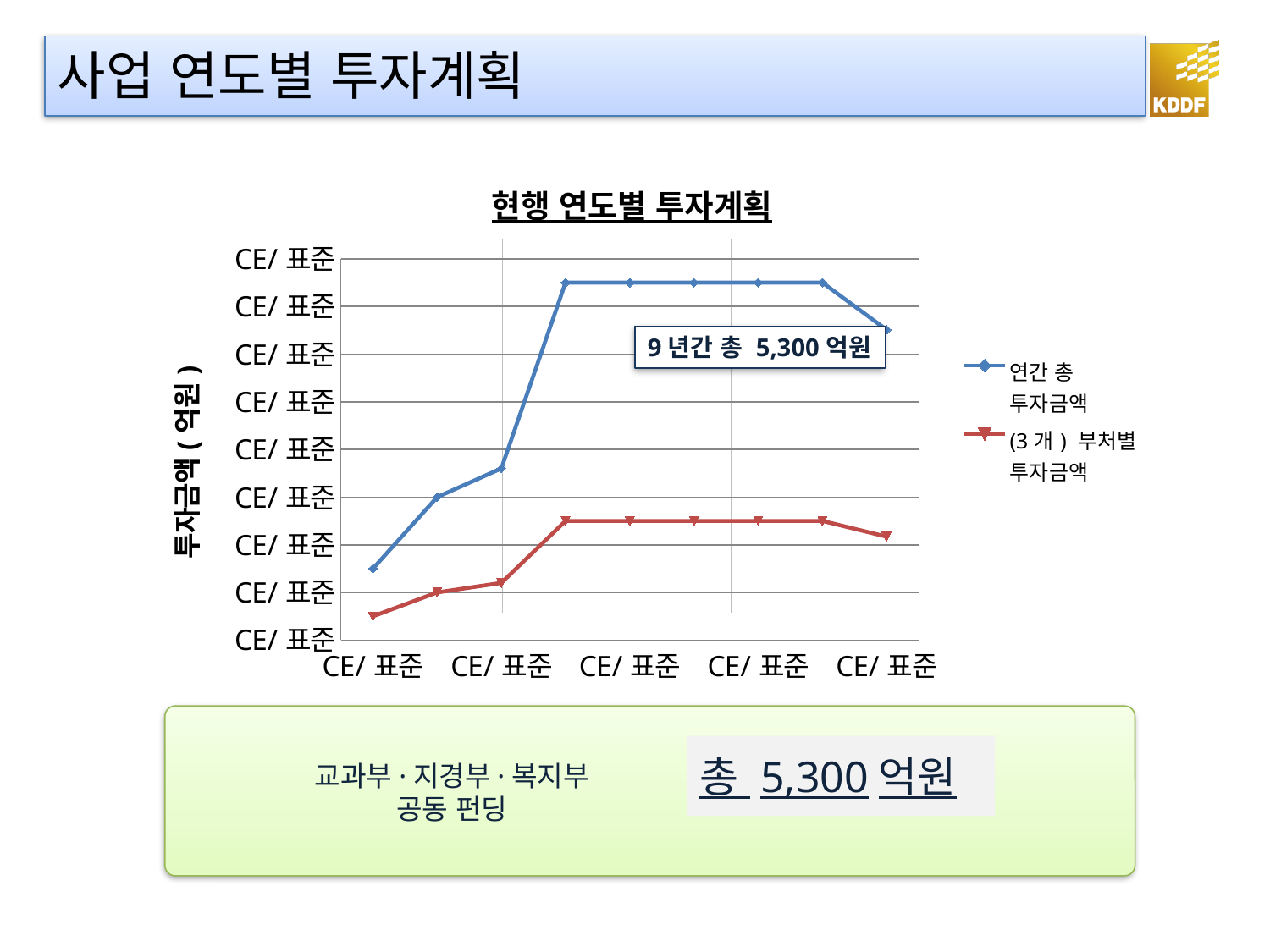
What is the title of the chart? 현행 연도별 투자계획 How many data points does the blue '연간 총 투자금액' line have? 9 How many data points does the red '(3개) 부처별 투자금액' line have? 9 Does the blue '연간 총 투자금액' line rise or fall between its first and second points? Rise Which series is plotted higher across all points, '연간 총 투자금액' or '(3개) 부처별 투자금액'? 연간 총 투자금액 Does the red '(3개) 부처별 투자금액' line rise or fall between its eighth and ninth (last) points? Fall How many series does the chart legend list? 2 Which series is drawn in red on the chart? (3개) 부처별 투자금액 What kind of chart is shown on the slide? Line chart For the blue '연간 총 투자금액' line, is the first point or the last point higher? The last point What total amount is stated in the annotation box inside the chart? 9 년간 총 5,300 억원